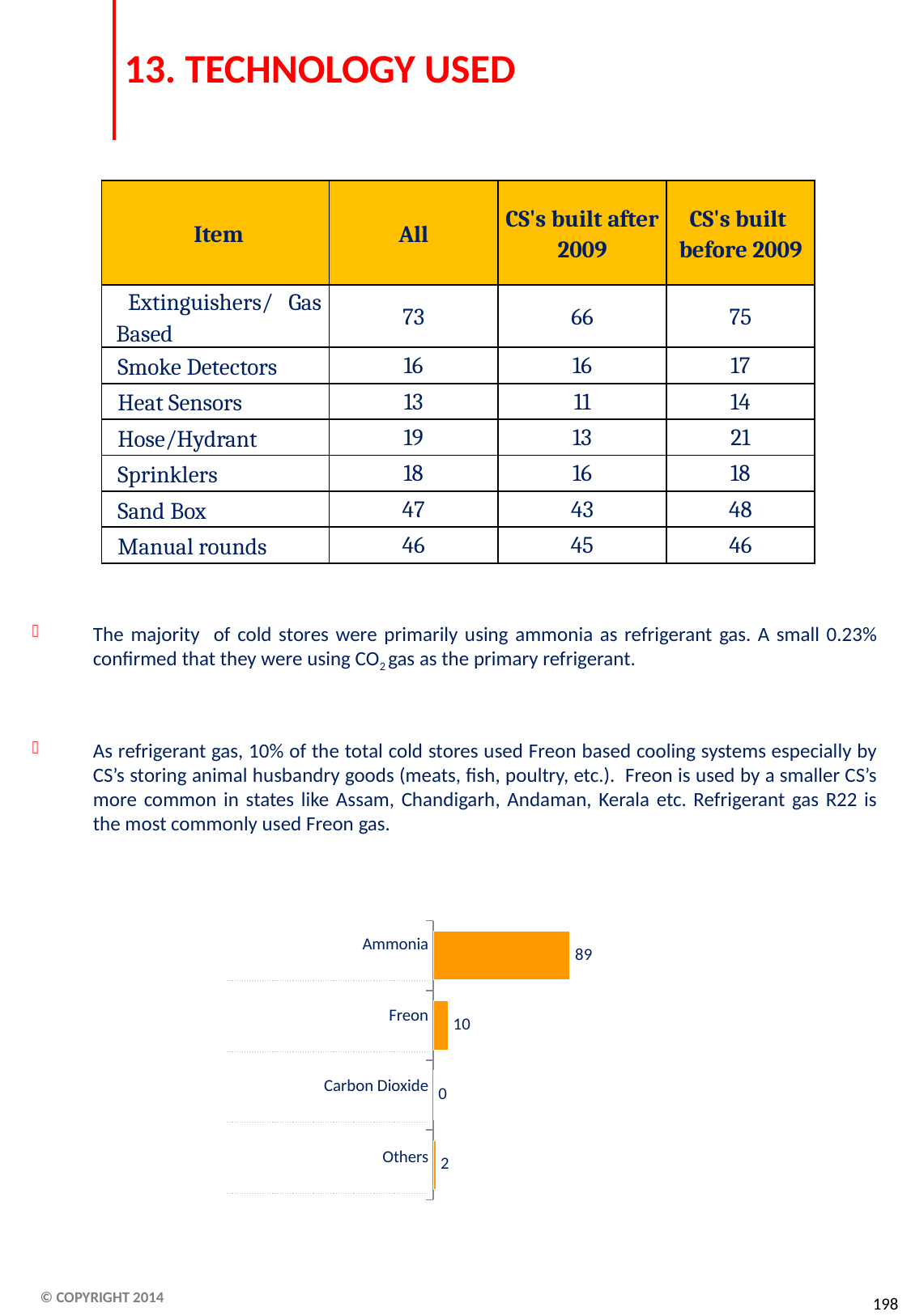
What is the total of all the values shown in the bar chart? 101 Which category has the lowest value in the bar chart? Carbon Dioxide What is the value for Freon in the bar chart? 10 What is the value for Others in the bar chart? 2 What is the difference between the values for Ammonia and Freon in the bar chart? 79 What is the value for Carbon Dioxide in the bar chart? 0 What is the value for Ammonia in the bar chart? 89 Which is larger in the bar chart, the value for Freon or the value for Others? Freon Which category has the highest value in the bar chart? Ammonia What colour are the bars in the chart? Orange How many categories are shown in the bar chart? 4 What kind of chart is shown on the slide? Bar chart